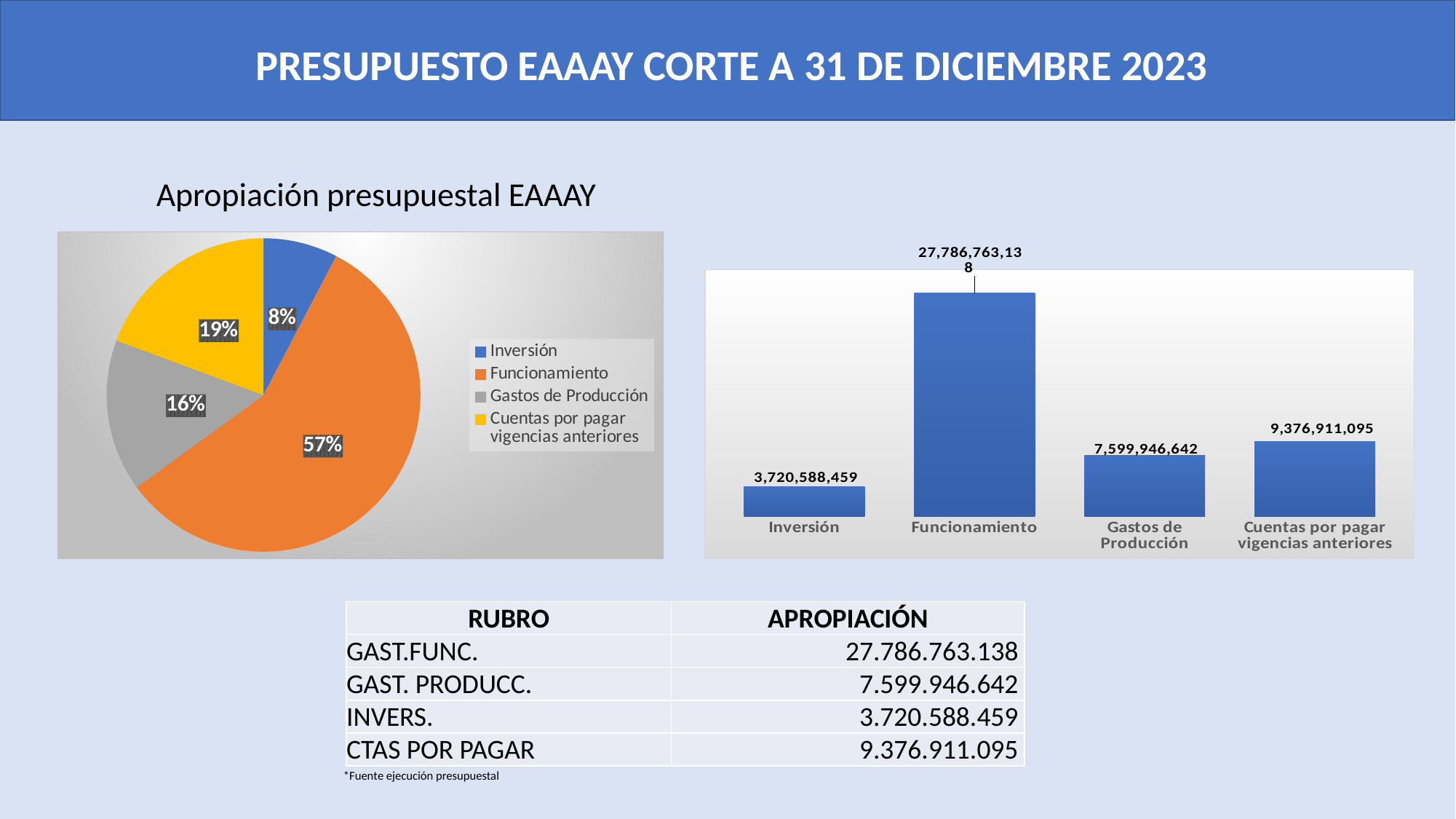
In the pie chart on the left, how many categories does the legend list? 4 In the pie chart on the left, which category has the smallest slice? Inversión In the bar chart on the right, which is larger: Gastos de Producción or Cuentas por pagar vigencias anteriores? Cuentas por pagar vigencias anteriores In the bar chart on the right, what is the value for Inversión? 3,720,588,459 What kind of chart is the chart on the left of the slide? Pie chart In the bar chart on the right, what is the difference between Cuentas por pagar vigencias anteriores and Gastos de Producción? 1,776,964,453 In the bar chart on the right, what is the value for Funcionamiento? 27,786,763,138 In the pie chart on the left, what share does Funcionamiento have? 57% In the pie chart on the left, what share does Cuentas por pagar vigencias anteriores have? 19% In the pie chart on the left, which colour represents Gastos de Producción? Grey What kind of chart is the chart on the right of the slide? Bar chart In the bar chart on the right, which category has the highest value? Funcionamiento